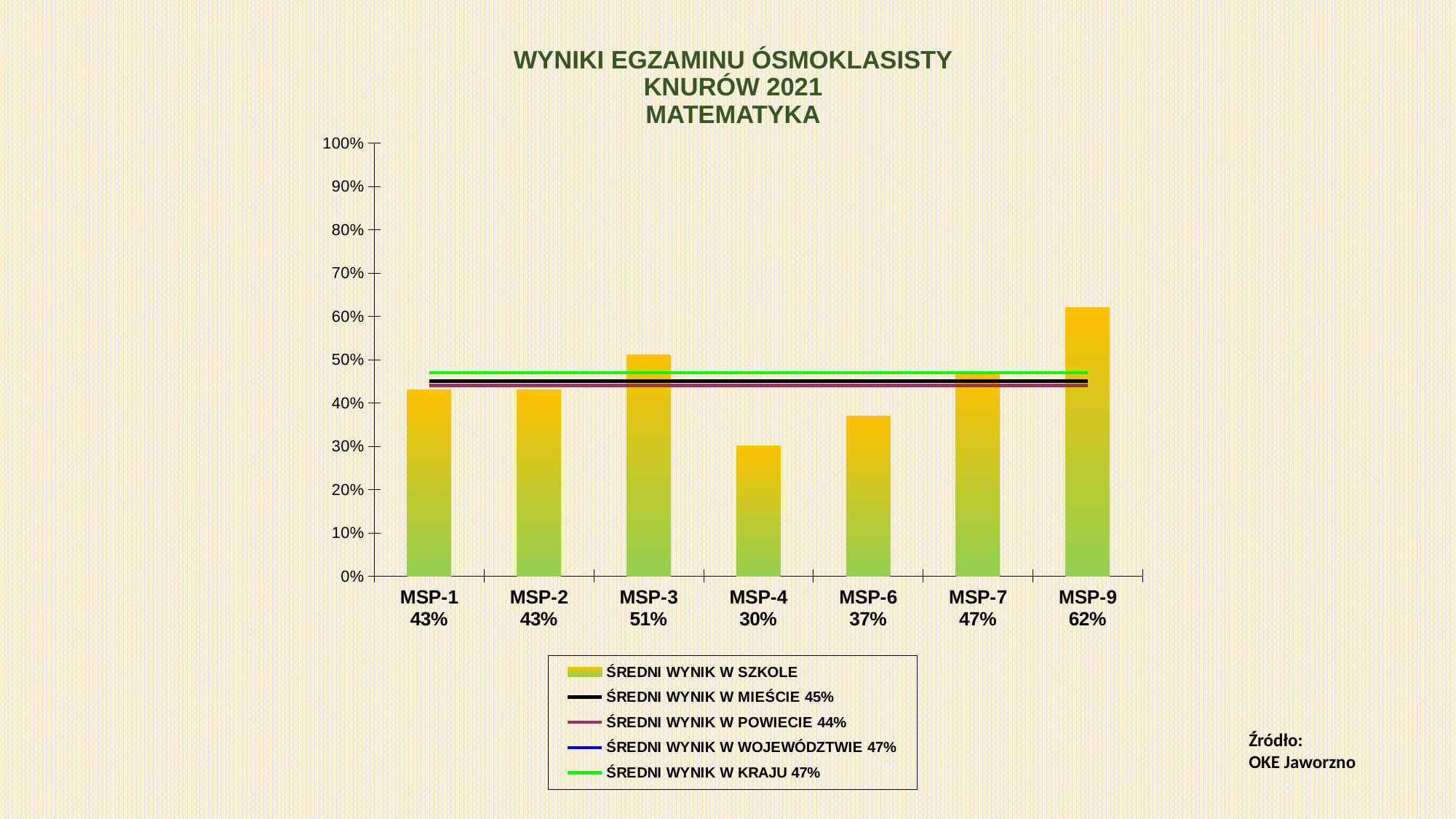
How many schools are shown on the x axis? 7 Is the value for MSP-9 greater or less than 60%? greater Which school has a higher result, MSP-6 or MSP-7? MSP-7 What is the source given for the data on the slide? OKE Jaworzno Which school has the lowest average result? MSP-4 Which school has the highest average result? MSP-9 What is the average school result (ŚREDNI WYNIK W SZKOLE) for MSP-3? 51% What is the difference between the results of MSP-9 and MSP-4? 32% What is the average result in the city (ŚREDNI WYNIK W MIEŚCIE) according to the legend? 45% How many series does the legend list? 5 What kind of chart is shown on the slide? combination bar and line chart What is the average school result for MSP-4? 30%